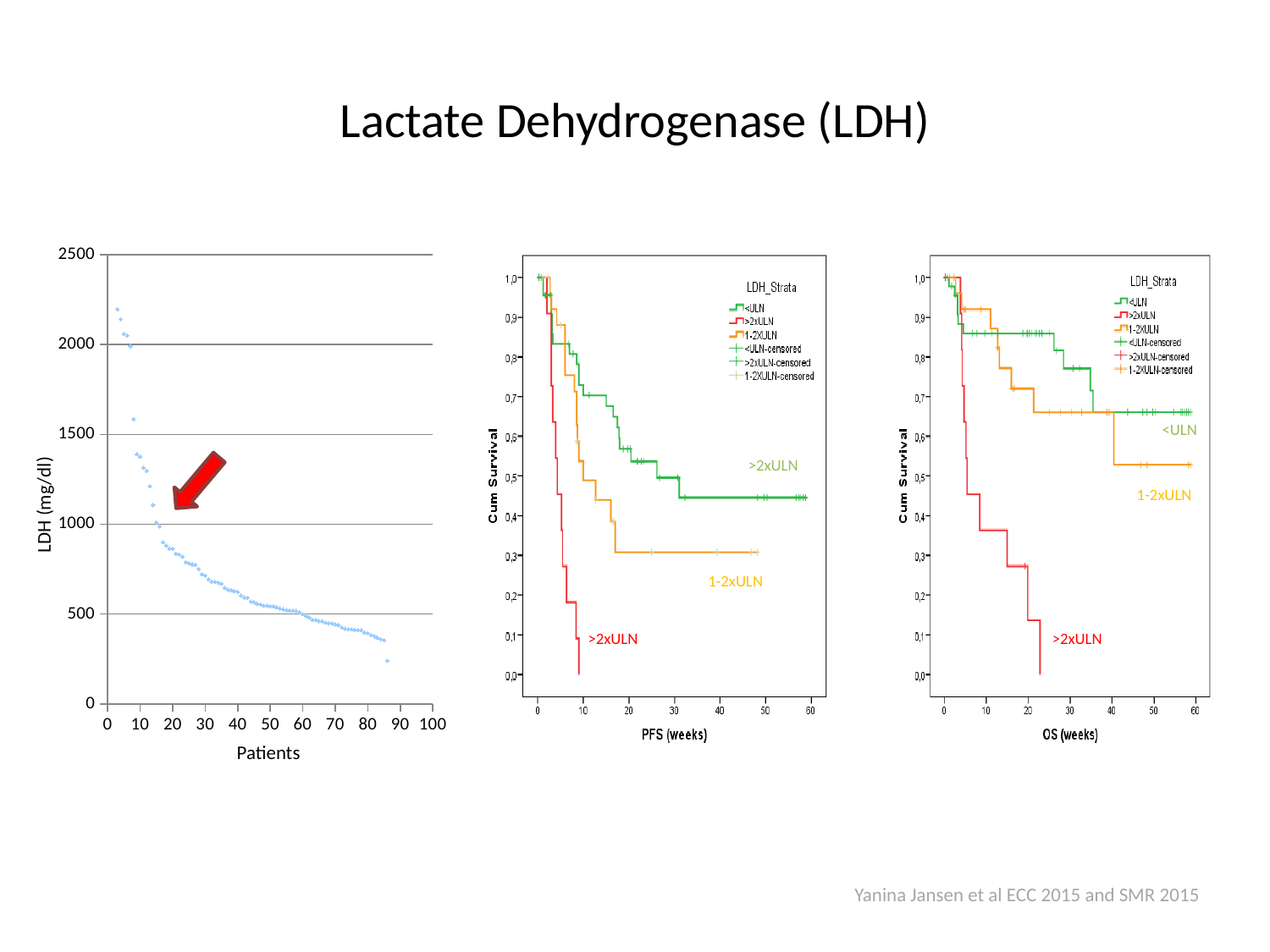
What kind of chart is the left chart showing LDH (mg/dl) against Patients? scatter chart In the left chart, what is the label of the y axis? LDH (mg/dl) In the left chart, is the LDH value of the last (rightmost) patient greater or less than 500? less In the right chart (OS), is the cumulative survival of the >2xULN curve at 20 weeks greater or less than 0.3? less In the middle chart (PFS), which LDH stratum has the lowest cumulative survival? >2xULN In the middle chart (PFS), how many entries does the LDH_Strata legend list? 6 In the middle chart, what is the label of the x axis? PFS (weeks) In the left chart, do the LDH values rise or fall as the patient number increases along the x axis? fall In the middle chart (PFS), is the cumulative survival of the 1-2xULN curve at 40 weeks greater or less than 0.4? less In the right chart (OS), which curve is higher at 50 weeks, the <ULN curve or the 1-2xULN curve? <ULN